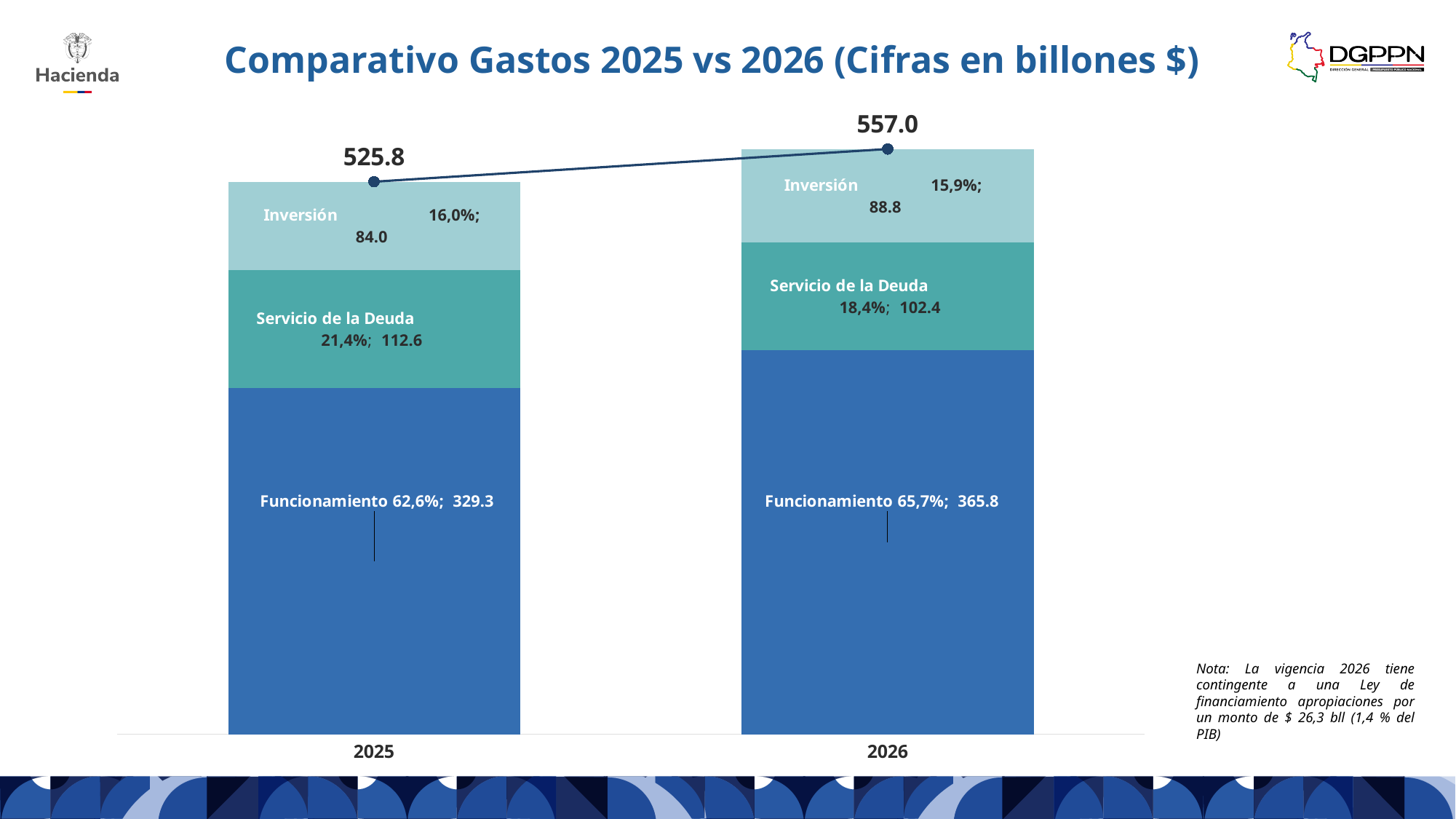
Does the total rise or fall from 2025 to 2026? Rises Which year has the larger Servicio de la Deuda value, 2025 or 2026? 2025 What kind of chart is shown? Stacked bar chart Which segment is the largest in the 2025 bar? Funcionamiento Which segment is the smallest in the 2026 bar? Inversión What is the value of Funcionamiento in 2026? 365.8 What is the difference between the 2026 total and the 2025 total? 31.2 How many years are compared on the x axis? 2 What percentage share does Inversión have in 2026? 15,9% What is the value of Servicio de la Deuda in 2025? 112.6 What is the total for 2025? 525.8 What is the total for 2026? 557.0